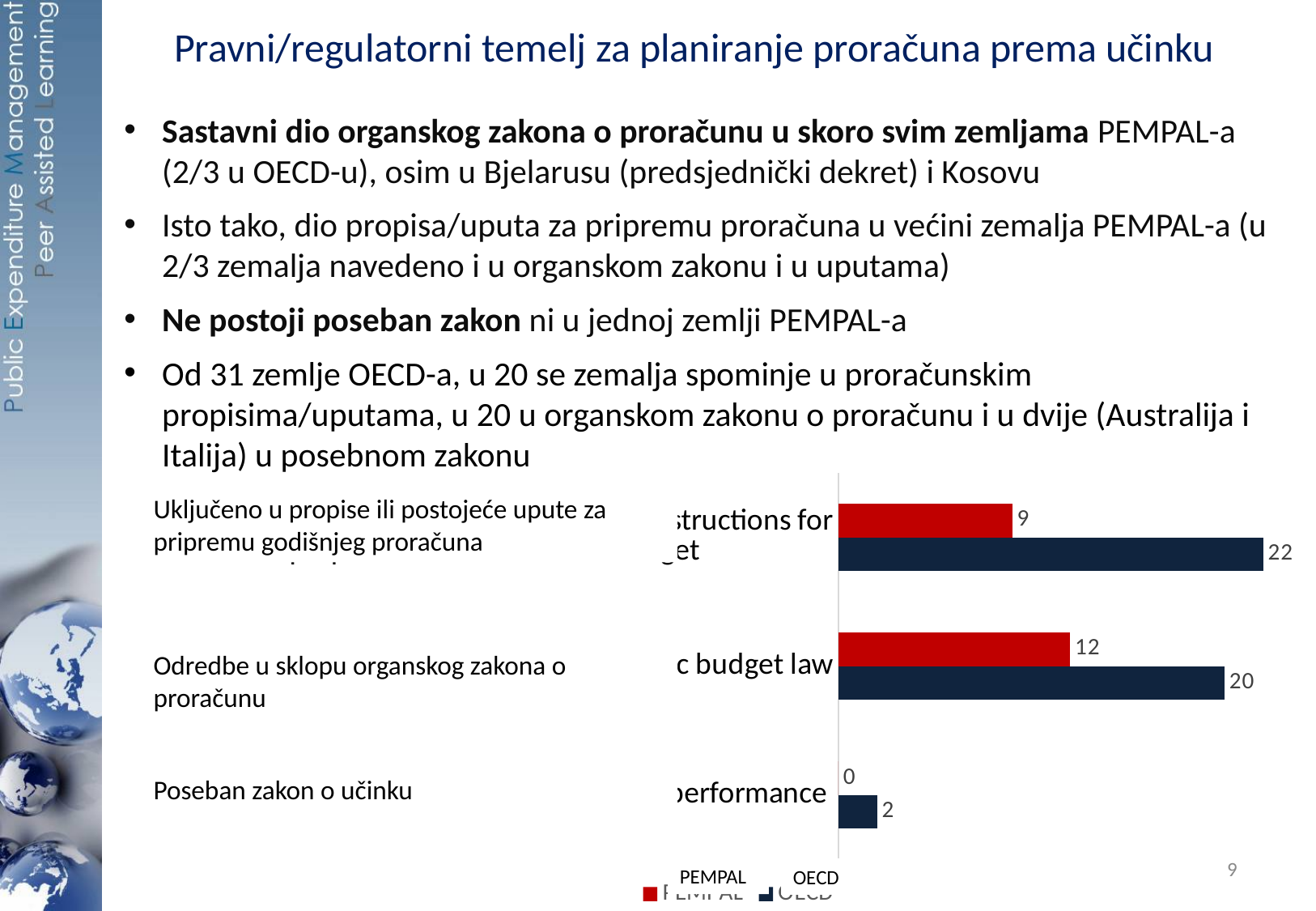
What type of chart is shown on the slide? bar chart What is the PEMPAL value for 'Odredbe u sklopu organskog zakona o proračunu'? 12 What is the OECD value for 'Uključeno u propise ili postojeće upute za pripremu godišnjeg proračuna'? 22 How many categories are shown in the chart? 3 What is the OECD value for 'Poseban zakon o učinku'? 2 What is the PEMPAL value for 'Uključeno u propise ili postojeće upute za pripremu godišnjeg proračuna'? 9 How many series does the chart legend list? 2 Which is larger for 'Odredbe u sklopu organskog zakona o proračunu': the PEMPAL value or the OECD value? OECD What is the PEMPAL value for 'Poseban zakon o učinku'? 0 What is the difference between the OECD and PEMPAL values for 'Uključeno u propise ili postojeće upute za pripremu godišnjeg proračuna'? 13 Which category has the highest PEMPAL value? Odredbe u sklopu organskog zakona o proračunu What is the OECD value for 'Odredbe u sklopu organskog zakona o proračunu'? 20